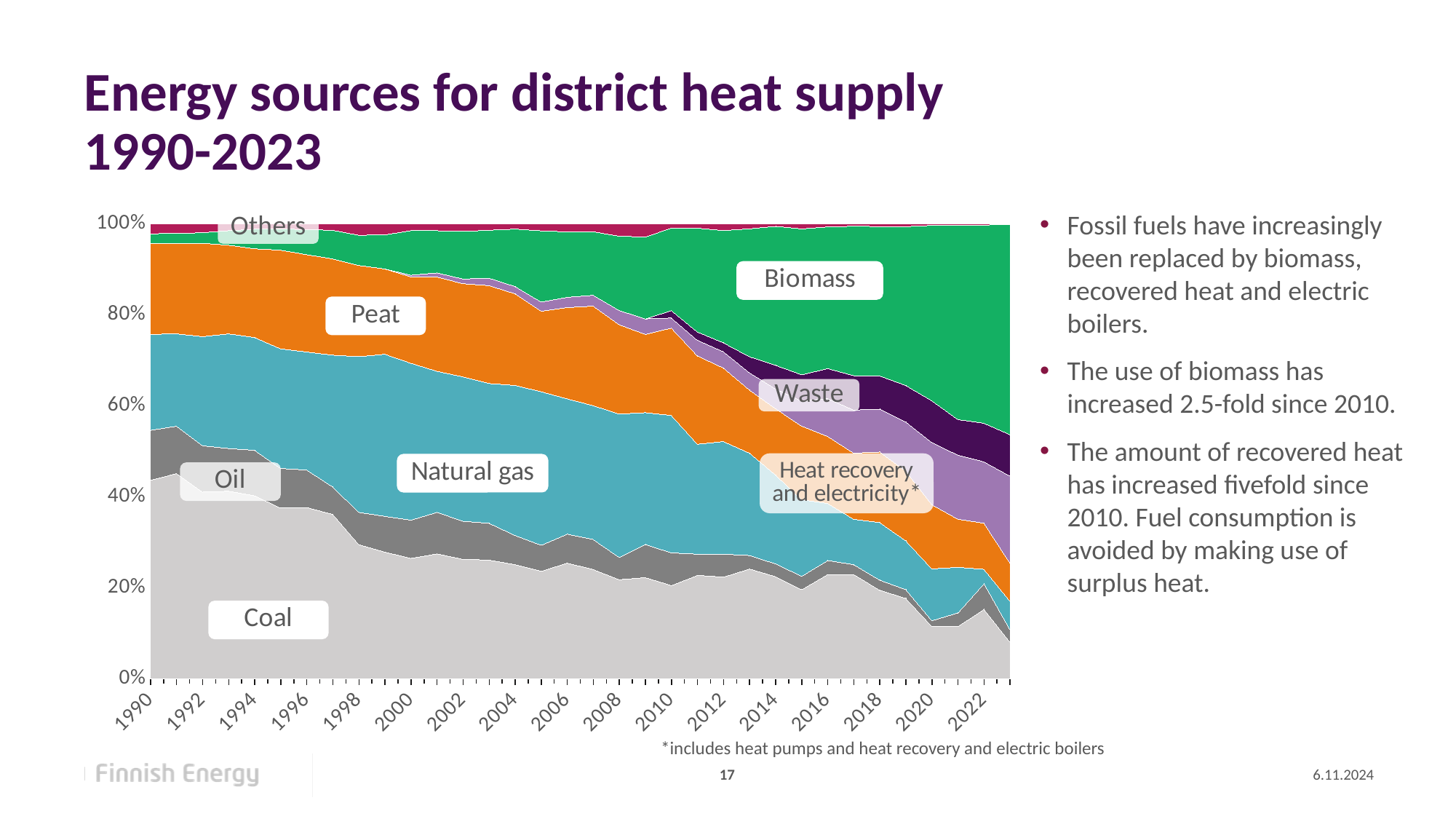
Is the share of coal in 1990 greater or less than 40%? greater Does the share of coal rise or fall from 1990 to 2023? Fall Is the share of coal in 2023 greater or less than 20%? less What is the highest value shown on the y axis? 100% Which energy source forms the bottom layer of the stacked area chart? Coal In 1990, which has the larger share: coal or biomass? Coal In 2023, which has the larger share: biomass or coal? Biomass How many energy source series are labelled in the chart? 8 Does the share of biomass rise or fall from 1990 to 2023? Rise What kind of chart is shown on the slide? Stacked area chart What is the first year shown on the x axis? 1990 What is the title of the chart on the slide? Energy sources for district heat supply 1990-2023